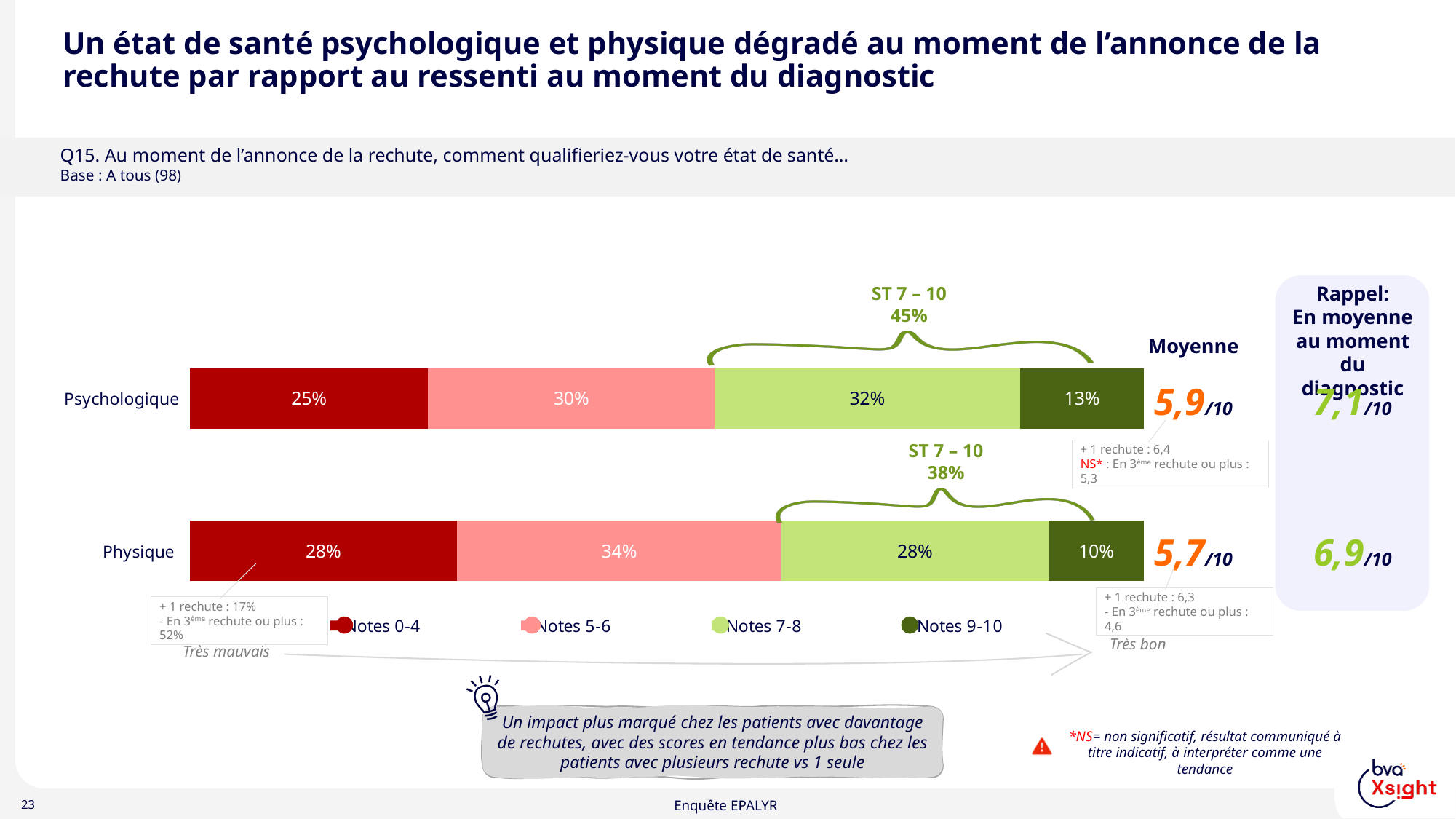
What kind of chart is shown on the slide? Stacked bar chart How many series does the legend list? 4 Which has a larger 'Notes 0-4' share, Psychologique or Physique? Physique What is the 'Notes 9-10' share for the Physique bar? 10% What percentage of respondents gave a score of 5-6 for their physical health? 34% How many categories (bars) does the chart show? 2 Which segment of the Physique bar is the smallest? Notes 9-10 Which segment of the Psychologique bar is the largest? Notes 7-8 What is the average score (Moyenne) shown for Psychologique? 5,9/10 What is the ST 7 – 10 value shown above the Physique bar? 38% What is the difference between the 'Notes 9-10' shares for Psychologique and Physique? 3 percentage points What percentage of respondents gave a score of 0-4 for their psychological health? 25%